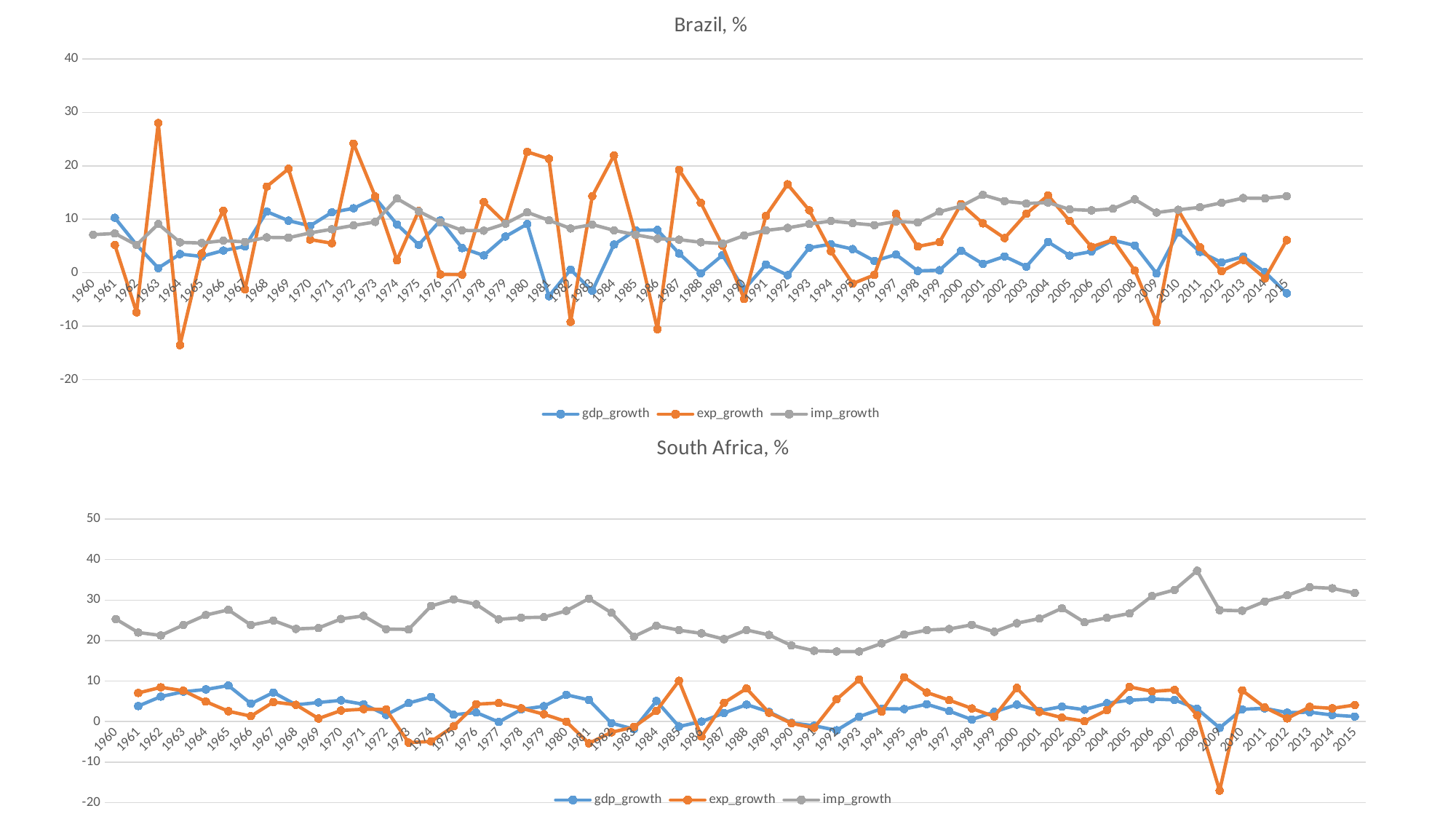
How many series does the legend of the South Africa, % chart list? 3 What kind of chart is the Brazil, % chart? line chart Which series is drawn in orange in the Brazil, % chart? exp_growth In the Brazil, % chart, is the imp_growth value for 2015 greater or less than 10? greater How many years are plotted on the x axis of the South Africa, % chart? 56 In the South Africa, % chart, which year has the highest imp_growth value? 2008 In the South Africa, % chart, is the imp_growth value for 1992 greater or less than 20? less In the Brazil, % chart, is the exp_growth value for 2009 greater or less than 0? less In the Brazil, % chart, which year has the highest exp_growth value? 1963 In the Brazil, % chart, which year has the lowest exp_growth value? 1964 In the South Africa, % chart, which series is larger in 2000: imp_growth or gdp_growth? imp_growth In the South Africa, % chart, which year has the lowest exp_growth value? 2009